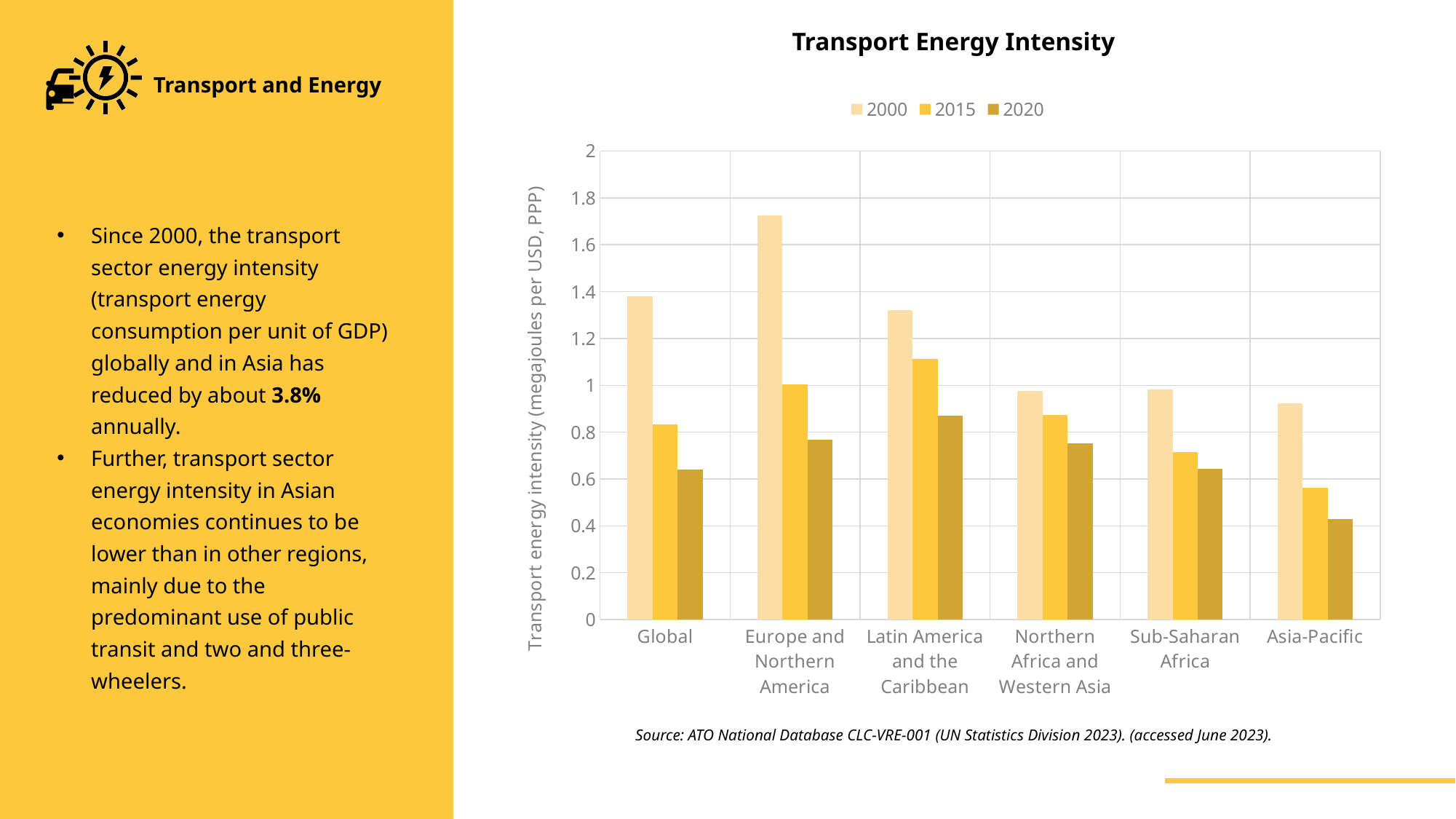
How many regions are shown on the x axis of the chart? 6 Which region has the highest transport energy intensity for 2000? Europe and Northern America Is the 2020 value for Asia-Pacific greater or less than 0.6? less For each region, do the values rise or fall from 2000 to 2020? fall What is the label on the vertical axis of the chart? Transport energy intensity (megajoules per USD, PPP) Is the 2000 value for Europe and Northern America greater or less than 1.6? greater Which is larger, the 2015 value for Global or the 2015 value for Asia-Pacific? Global What kind of chart is shown on the slide? Bar chart Which region has the lowest transport energy intensity for 2020? Asia-Pacific Is the 2015 value for Latin America and the Caribbean greater or less than 1? greater Which region has the highest transport energy intensity for 2020? Latin America and the Caribbean How many series does the legend of the Transport Energy Intensity chart list? 3